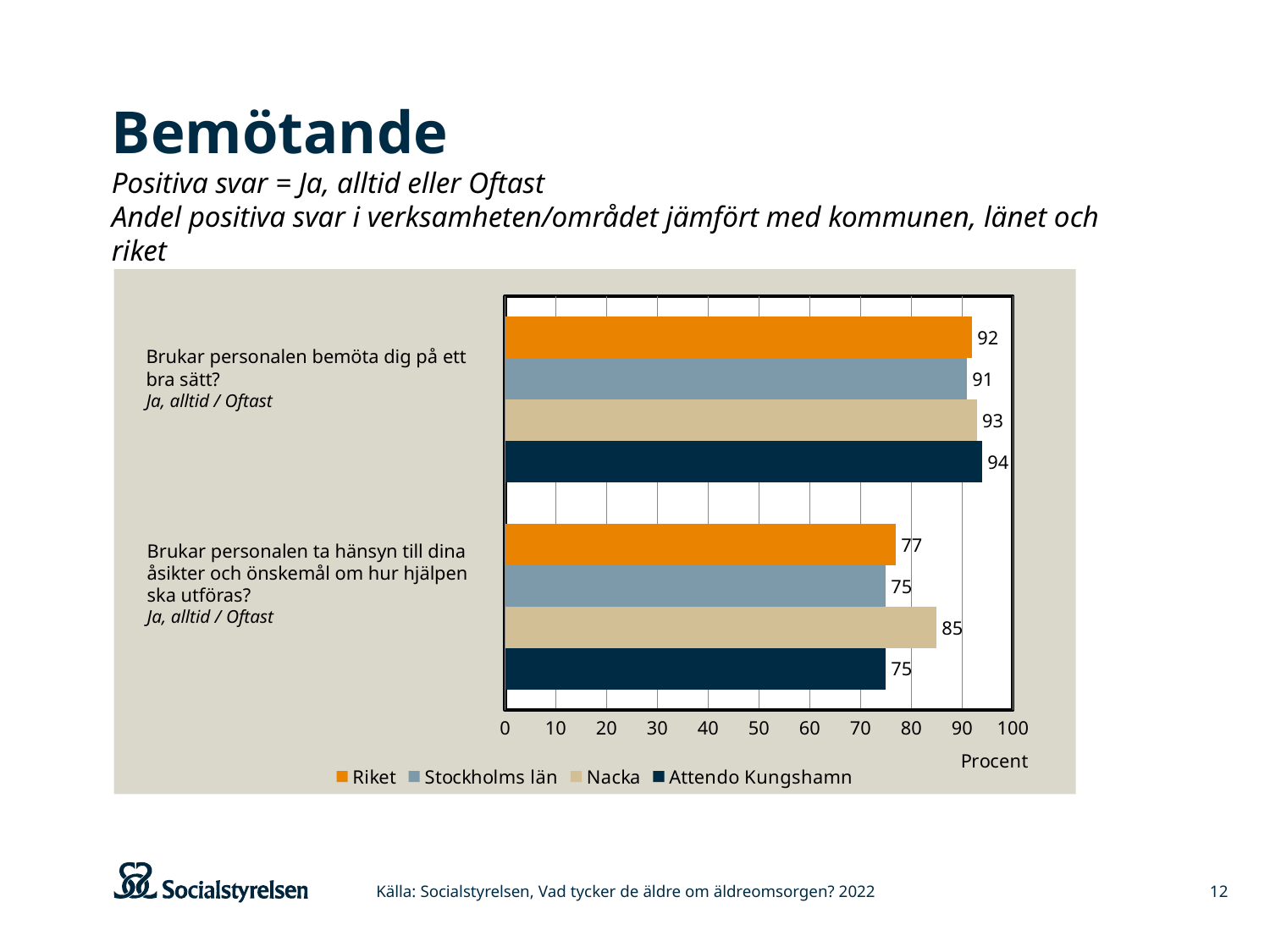
Which series has the lowest value for the question 'Brukar personalen bemöta dig på ett bra sätt?' Stockholms län Which series has the highest value for the question 'Brukar personalen ta hänsyn till dina åsikter och önskemål om hur hjälpen ska utföras?' Nacka What kind of chart is shown on the slide? Bar chart How many questions (categories) are shown on the chart? 2 For the question 'Brukar personalen bemöta dig på ett bra sätt?', which is larger: the value for Riket or the value for Stockholms län? Riket What unit is shown on the x axis of the chart? Procent What value does Attendo Kungshamn have for the question 'Brukar personalen bemöta dig på ett bra sätt?' 94 What value does Riket have for the question 'Brukar personalen ta hänsyn till dina åsikter och önskemål om hur hjälpen ska utföras?' 77 What is the difference between the Nacka and Riket values for the question 'Brukar personalen ta hänsyn till dina åsikter och önskemål om hur hjälpen ska utföras?' 8 What value does Nacka have for the question 'Brukar personalen ta hänsyn till dina åsikter och önskemål om hur hjälpen ska utföras?' 85 How many series does the legend list? 4 Which series has the highest value for the question 'Brukar personalen bemöta dig på ett bra sätt?' Attendo Kungshamn